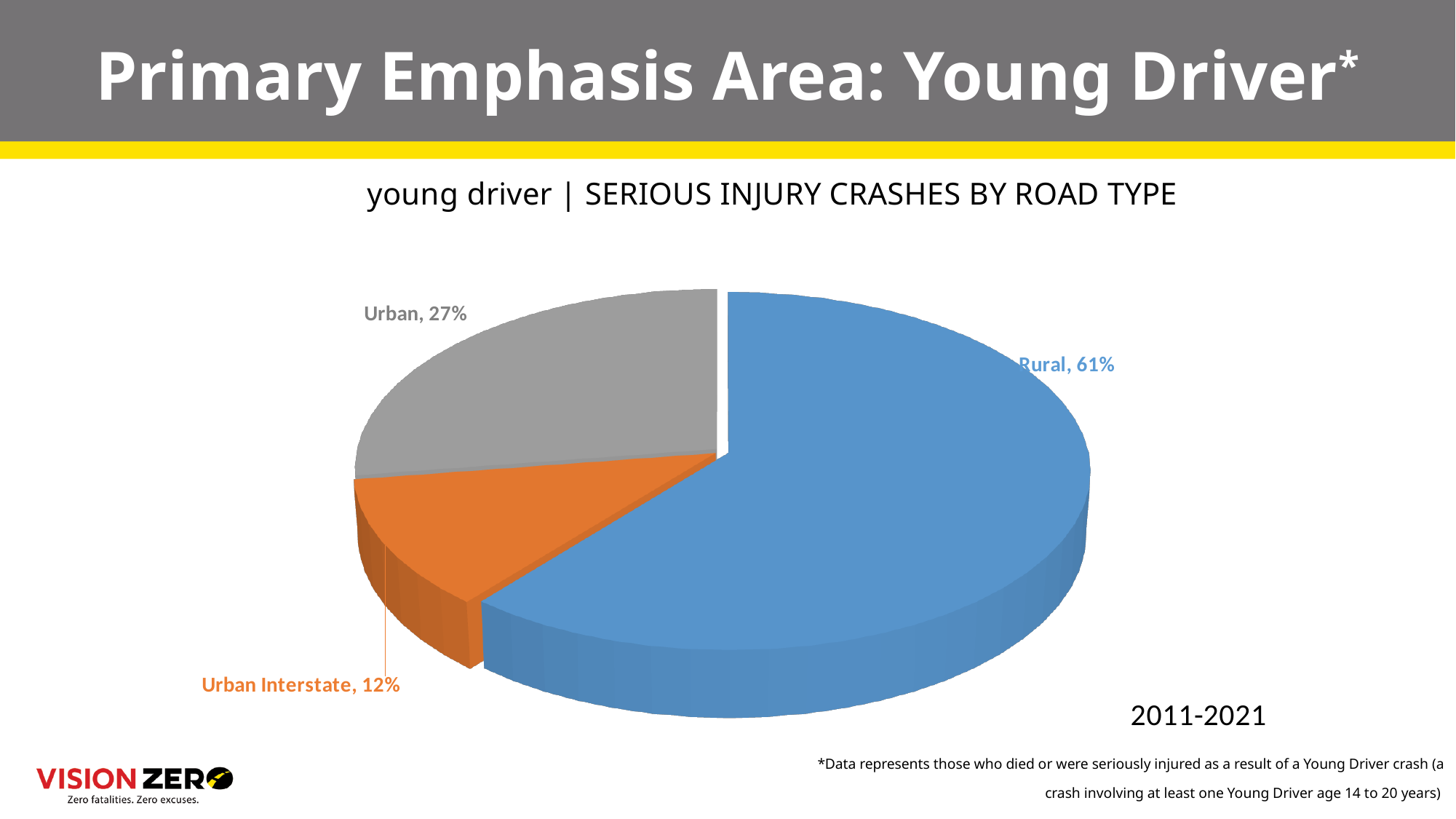
What share of young driver serious injury crashes occurred on Urban Interstate roads? 12% What share of young driver serious injury crashes occurred on Urban roads? 27% How many road type categories are shown in the pie chart? 3 What time period does the chart cover? 2011-2021 What is the title of the chart? young driver | SERIOUS INJURY CRASHES BY ROAD TYPE What is the difference in percentage points between the Urban and Urban Interstate shares? 15 Which road type has the smallest share of young driver serious injury crashes? Urban Interstate Which is larger, the Urban share or the Urban Interstate share? Urban Which road type has the largest share of young driver serious injury crashes? Rural What is the difference in percentage points between the Rural and Urban shares? 34 What share of young driver serious injury crashes occurred on Rural roads? 61% What kind of chart is shown on the slide? Pie chart